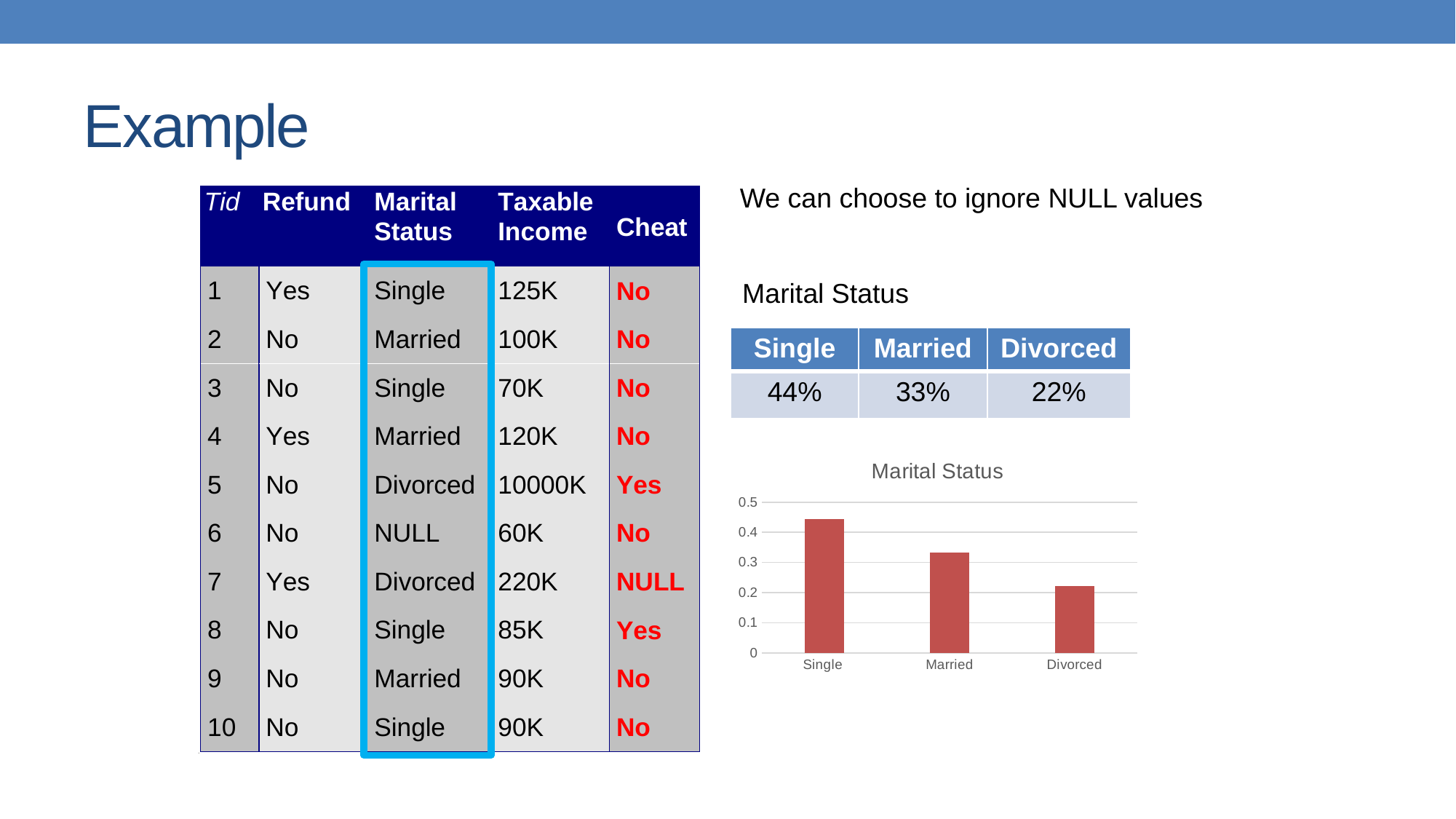
Is the value for Married greater or less than 0.3? greater What is the title of the chart? Marital Status What is the highest tick value shown on the chart's vertical axis? 0.5 Which category has the highest bar in the chart? Single Is the value for Married greater or less than 0.4? less Is the value for Single greater or less than 0.4? greater What kind of chart is shown on the slide? bar chart Do the bar values rise or fall from left to right across the x axis? fall Which category has the lowest bar in the chart? Divorced How many categories are shown on the x axis of the chart? 3 Which is larger in the chart, the bar for Married or the bar for Divorced? Married